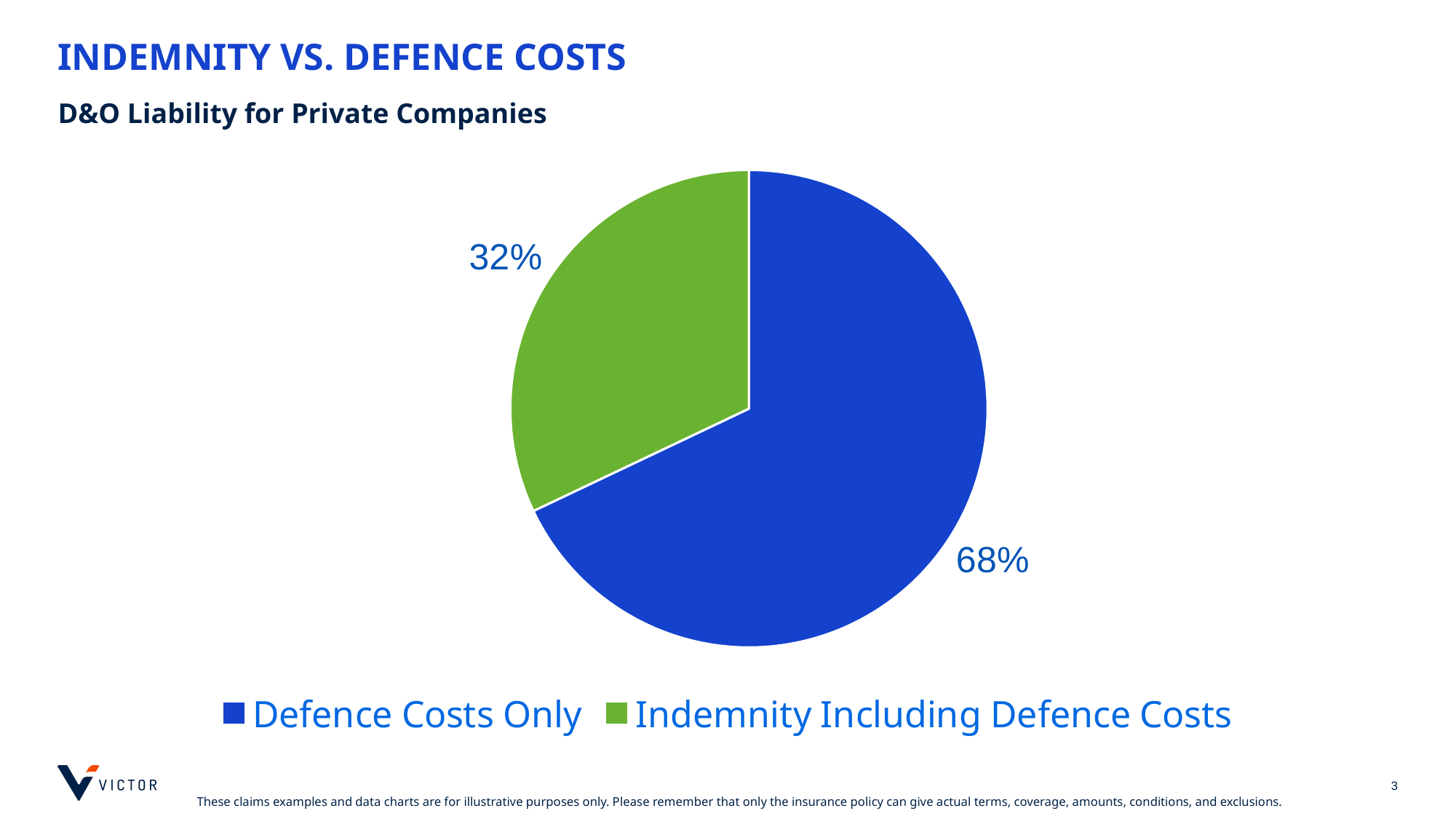
Which is larger: Defence Costs Only or Indemnity Including Defence Costs? Defence Costs Only What percentage of the pie is Defence Costs Only? 68% What kind of chart is shown on the slide? Pie chart What is the difference in percentage points between the Defence Costs Only slice and the Indemnity Including Defence Costs slice? 36 Which slice of the pie is the smallest? Indemnity Including Defence Costs What colour is the Defence Costs Only slice? Blue What share of the pie does the Indemnity Including Defence Costs slice represent? 32% How many entries does the legend list? 2 What is the title of the slide containing the chart? INDEMNITY VS. DEFENCE COSTS What percentage of the pie is Indemnity Including Defence Costs? 32% Which slice of the pie is the largest? Defence Costs Only How many slices does the pie chart have? 2